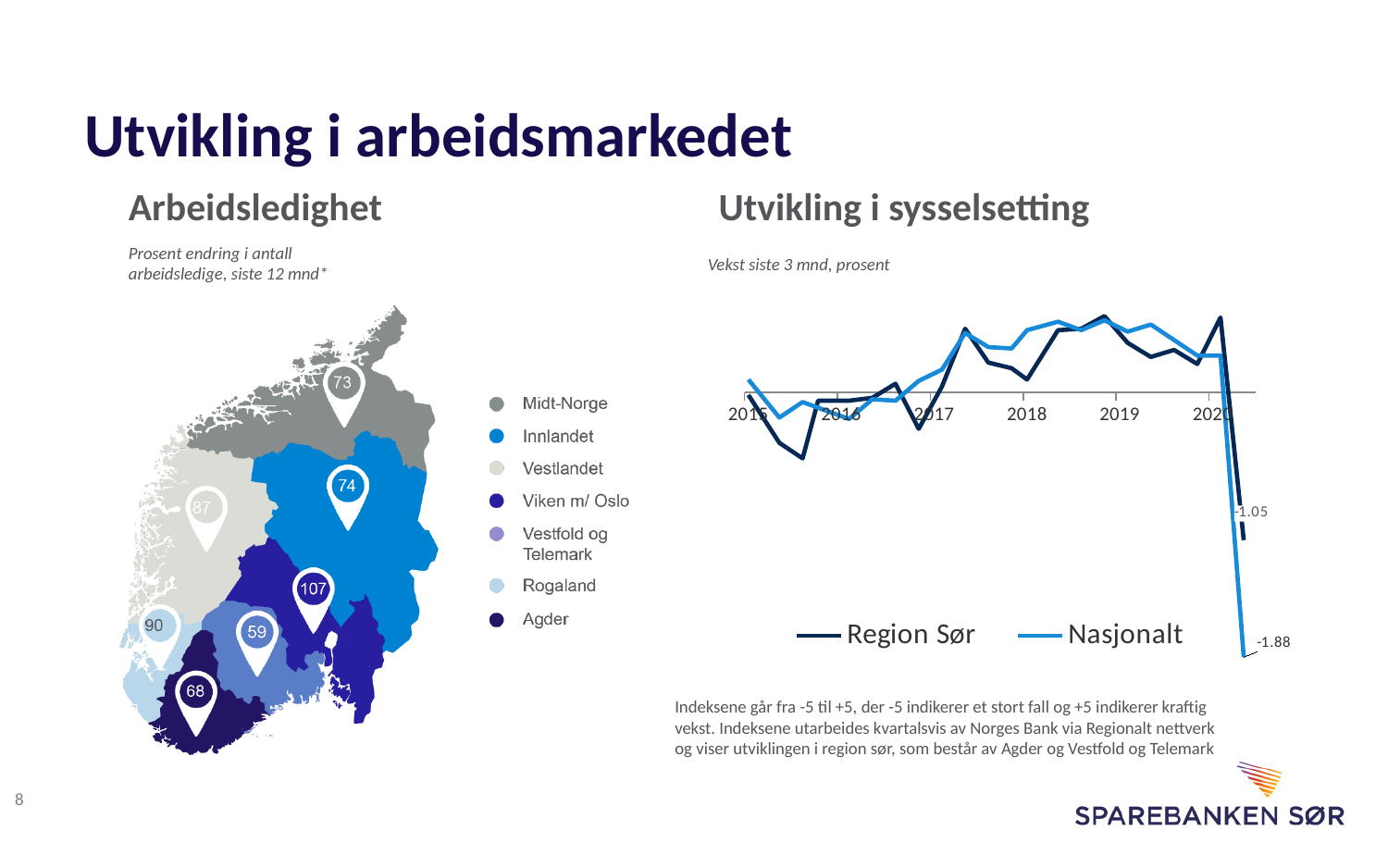
In the 'Arbeidsledighet' map, what is the value shown for Agder? 68 In the 'Utvikling i sysselsetting' chart, how many year labels are shown on the x axis? 6 In the 'Arbeidsledighet' map, which region has the lowest value? Vestfold og Telemark What kind of chart is 'Utvikling i sysselsetting'? Line chart In the 'Utvikling i sysselsetting' chart, do both series rise or fall sharply after 2020? Fall In the 'Arbeidsledighet' map, which region has the highest value? Viken m/ Oslo In the 'Utvikling i sysselsetting' chart, how many series does the legend list? 2 In the 'Utvikling i sysselsetting' chart, what is the final labelled value for Nasjonalt? -1.88 In the 'Utvikling i sysselsetting' chart, what is the difference between the final values of Region Sør (-1.05) and Nasjonalt (-1.88)? 0.83 In the 'Utvikling i sysselsetting' chart, which series has the lower final value, Region Sør or Nasjonalt? Nasjonalt In the 'Utvikling i sysselsetting' chart, what is the final labelled value for Region Sør? -1.05 In the 'Utvikling i sysselsetting' chart, what are the two series named in the legend? Region Sør and Nasjonalt